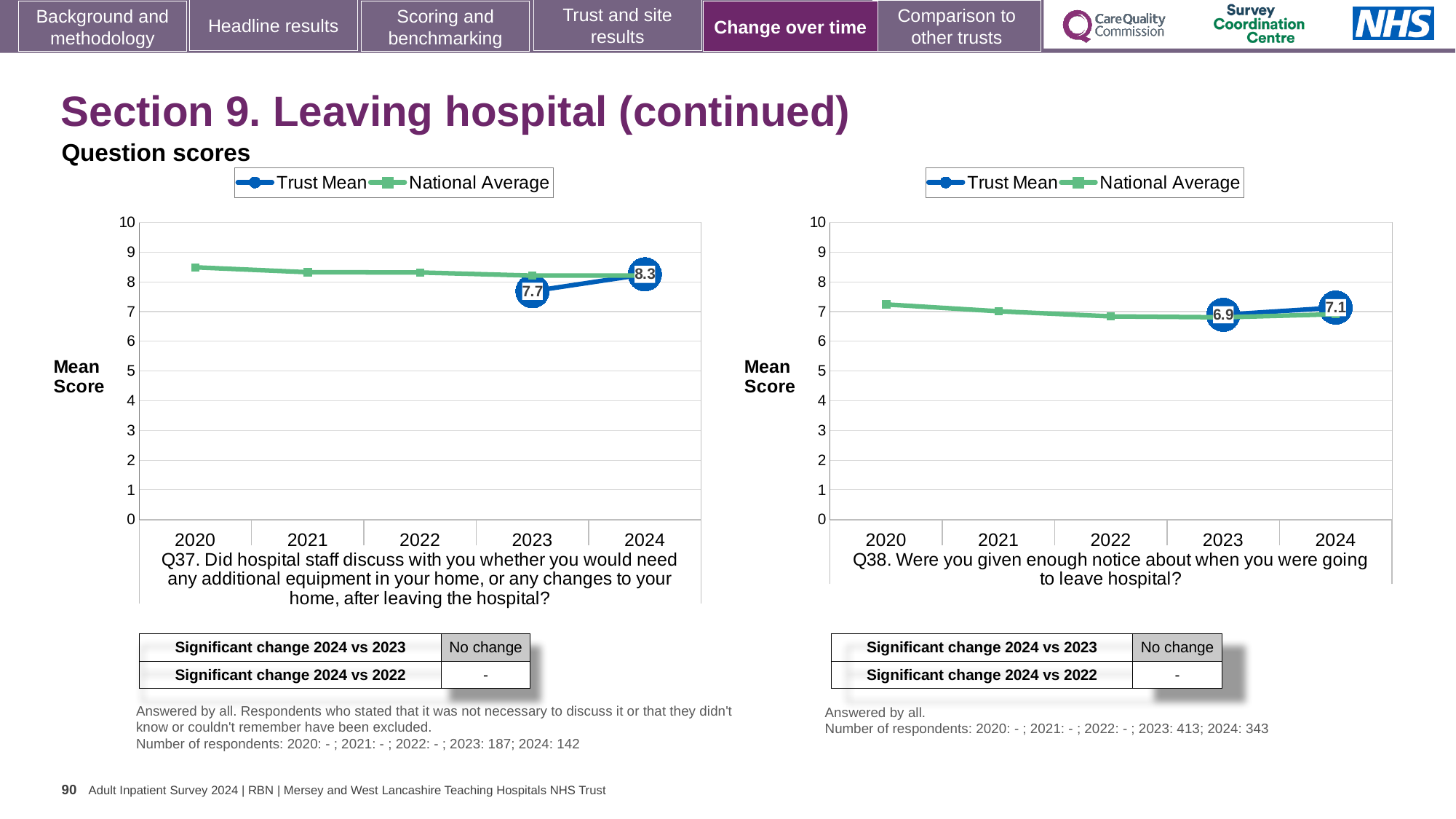
How many series does the legend of the Q37 chart on the left list? 2 In the Q37 chart on the left, what is the Trust Mean value for 2024? 8.3 In the Q38 chart on the right, is the National Average value for 2020 greater or less than 8? less In the Q37 chart on the left, is the Trust Mean higher in 2023 or 2024? 2024 In the Q38 chart on the right, what is the Trust Mean value for 2024? 7.1 In the Q37 chart on the left, is the National Average value for 2020 greater or less than 8? greater In the Q38 chart on the right, what is the Trust Mean value for 2023? 6.9 In the Q38 chart on the right, what is the difference between the Trust Mean for 2024 and 2023? 0.2 In the Q37 chart on the left, by how much did the Trust Mean change from 2023 to 2024? 0.6 What kind of chart is the Q38 chart on the right? Line chart In the Q37 chart on the left, what is the Trust Mean value for 2023? 7.7 How many years are shown on the x axis of the Q38 chart on the right? 5